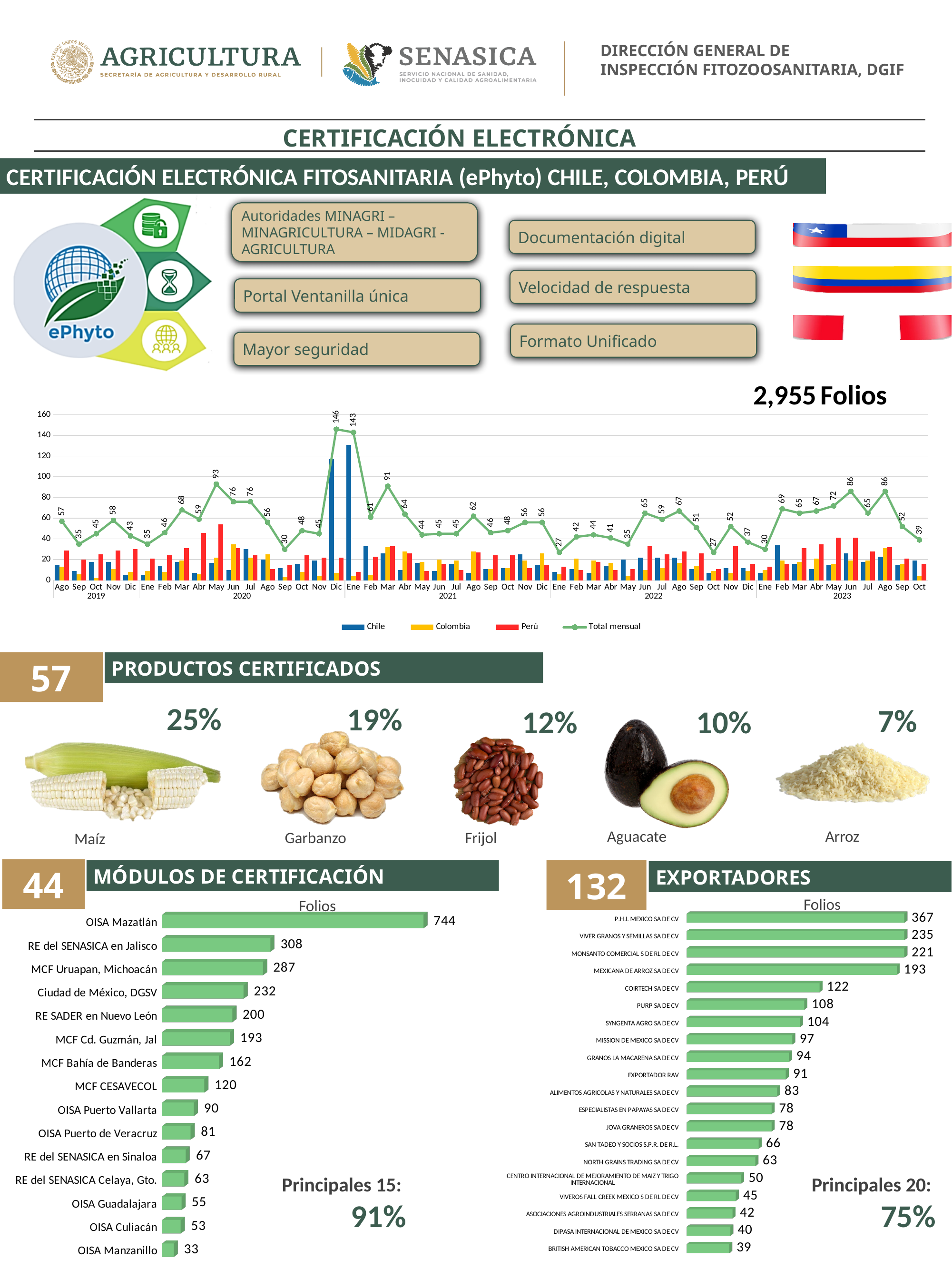
In the monthly folios chart at the top, what is the Total mensual value for Mar 2020? 68 In the Módulos de Certificación chart, which module has the lowest number of folios? OISA Manzanillo In the Módulos de Certificación chart, how many folios does OISA Mazatlán have? 744 In the monthly folios chart at the top, what is the difference between the Total mensual values for Dic 2020 and Ene 2021? 3 In the Módulos de Certificación chart, what is the difference in folios between OISA Mazatlán and RE del SENASICA en Jalisco? 436 In the Exportadores chart, how many folios does COIRTECH SA DE CV have? 122 In the monthly folios chart at the top, how many series does the legend list? 4 In the Módulos de Certificación chart, how many modules are listed? 15 In the monthly folios chart at the top, which month has the highest Total mensual value? Dic 2020 What kind of chart is the Exportadores chart? Bar chart In the Módulos de Certificación chart, which has more folios, MCF Uruapan, Michoacán or Ciudad de México, DGSV? MCF Uruapan, Michoacán In the Exportadores chart, which exporter has the highest number of folios? P.H.I. MEXICO SA DE CV